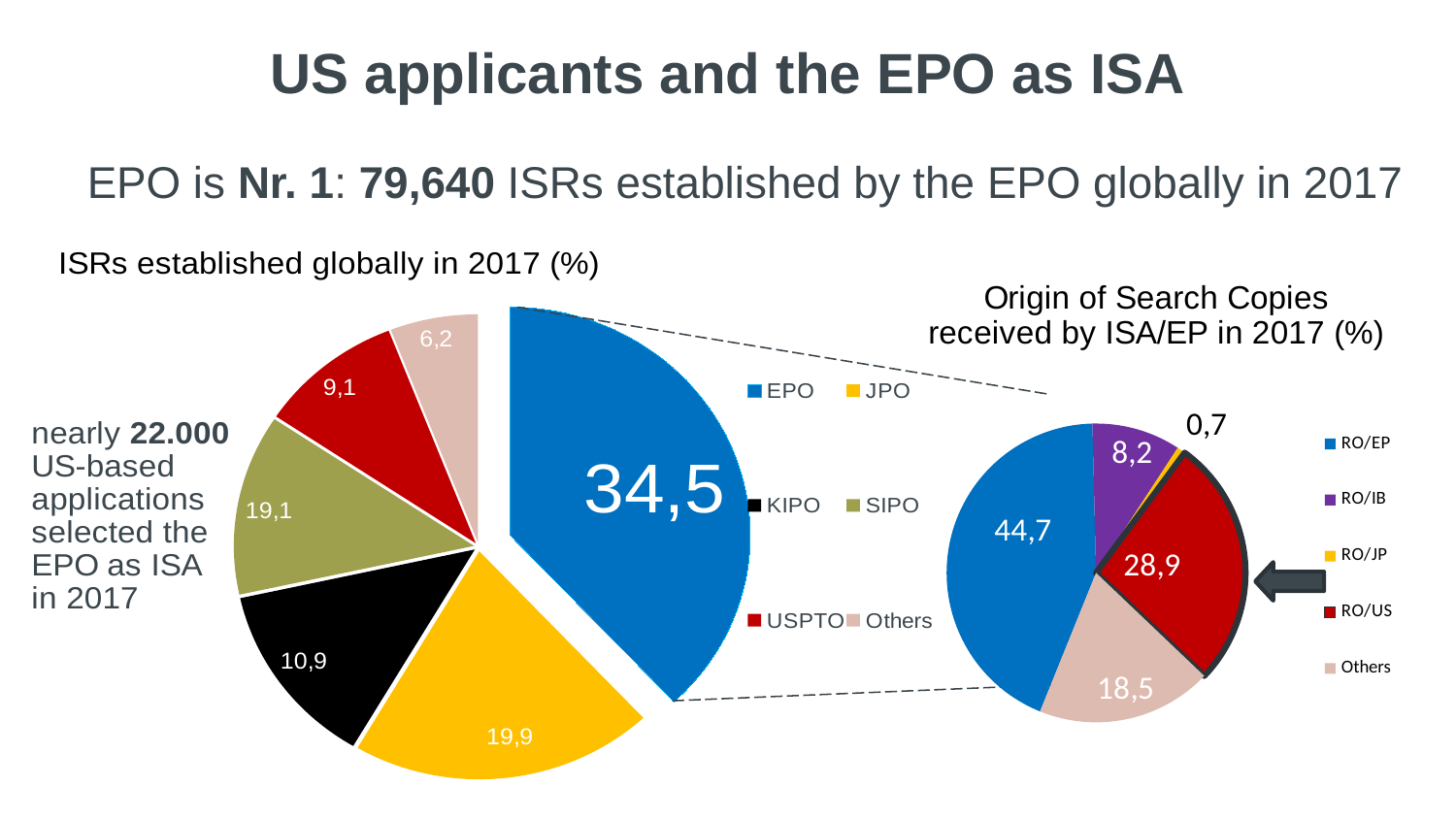
In the 'Origin of Search Copies received by ISA/EP in 2017 (%)' pie chart, which category has the largest slice? RO/EP In the 'Origin of Search Copies received by ISA/EP in 2017 (%)' pie chart, what colour is the RO/IB slice? Purple In the 'ISRs established globally in 2017 (%)' pie chart, what is the difference between the JPO and USPTO values? 10,8 In the 'Origin of Search Copies received by ISA/EP in 2017 (%)' pie chart, which is larger, RO/IB or Others? Others In the 'ISRs established globally in 2017 (%)' pie chart, what is the value for KIPO? 10,9 In the 'ISRs established globally in 2017 (%)' pie chart, which category has the largest slice? EPO In the 'ISRs established globally in 2017 (%)' pie chart, how many categories are shown? 6 In the 'ISRs established globally in 2017 (%)' pie chart, which category has the smallest slice? Others In the 'ISRs established globally in 2017 (%)' pie chart, what is the value for EPO? 34,5 In the 'Origin of Search Copies received by ISA/EP in 2017 (%)' pie chart, what is the value for RO/US? 28,9 What type of chart is used for 'Origin of Search Copies received by ISA/EP in 2017 (%)'? Pie chart In the 'Origin of Search Copies received by ISA/EP in 2017 (%)' pie chart, what is the value for RO/JP? 0,7